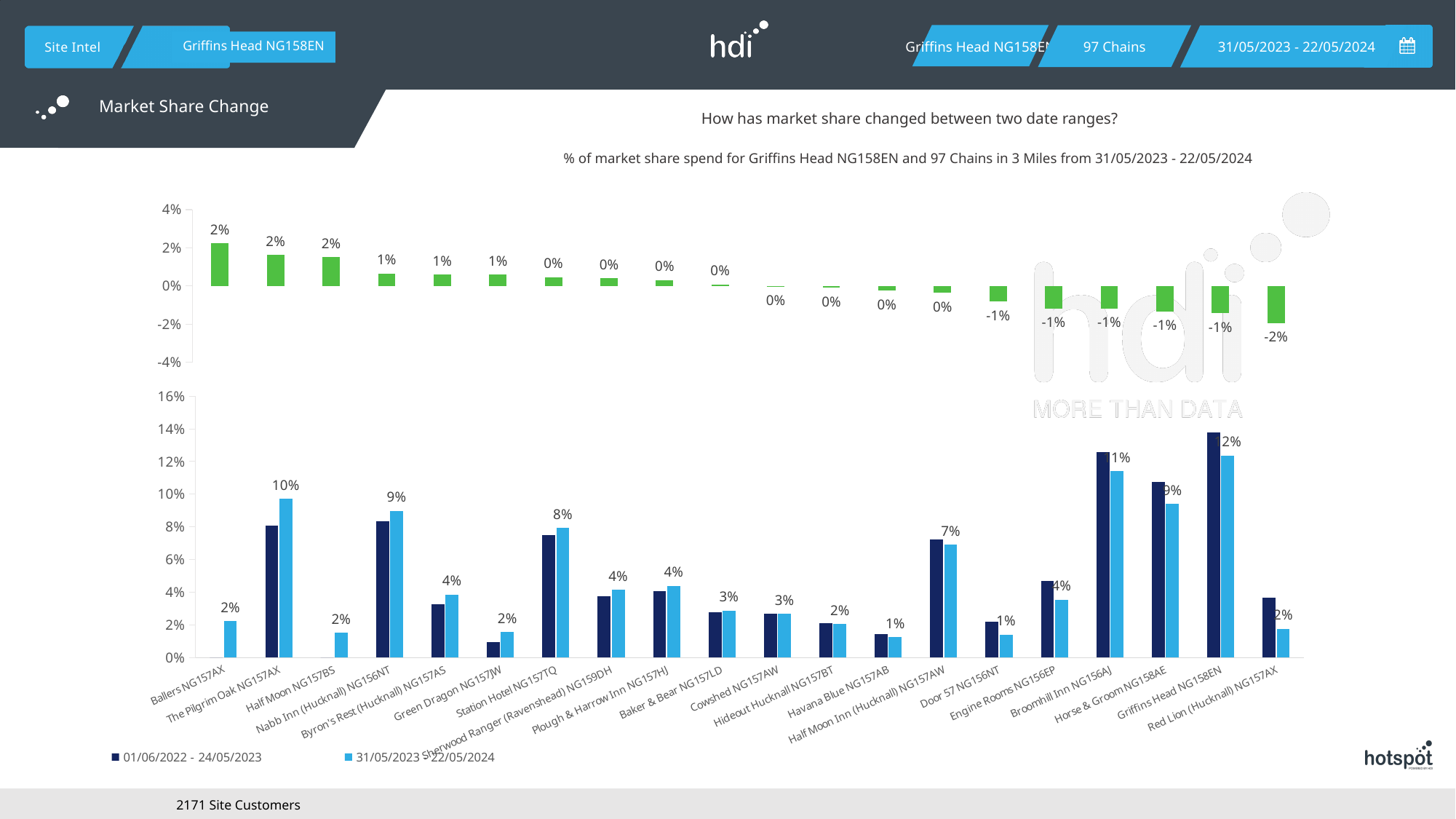
What are the two legend entries of the bottom chart? 01/06/2022 - 24/05/2023 and 31/05/2023 - 22/05/2024 In the bottom chart, what is the value for Griffins Head NG158EN in the 31/05/2023 - 22/05/2024 series? 12% In the bottom chart, which is larger in the 31/05/2023 - 22/05/2024 series: Nabb Inn (Hucknall) NG156NT or Station Hotel NG157TQ? Nabb Inn (Hucknall) NG156NT How many categories are shown on the x axis of the bottom chart? 20 How many series does the legend of the bottom chart list? 2 In the bottom chart, what is the value for The Pilgrim Oak NG157AX in the 31/05/2023 - 22/05/2024 series? 10% In the bottom chart, what is the value for Half Moon Inn (Hucknall) NG157AW in the 31/05/2023 - 22/05/2024 series? 7% What kind of chart is the bottom chart? bar chart In the bottom chart, is the value for Griffins Head NG158EN in the 01/06/2022 - 24/05/2023 series greater or less than 12%? greater In the bottom chart, which category has the highest value in the 31/05/2023 - 22/05/2024 series? Griffins Head NG158EN In the top chart, what is the lowest value shown? -2% In the bottom chart, what is the difference between Griffins Head NG158EN and Broomhill Inn NG156AJ in the 31/05/2023 - 22/05/2024 series? 1%